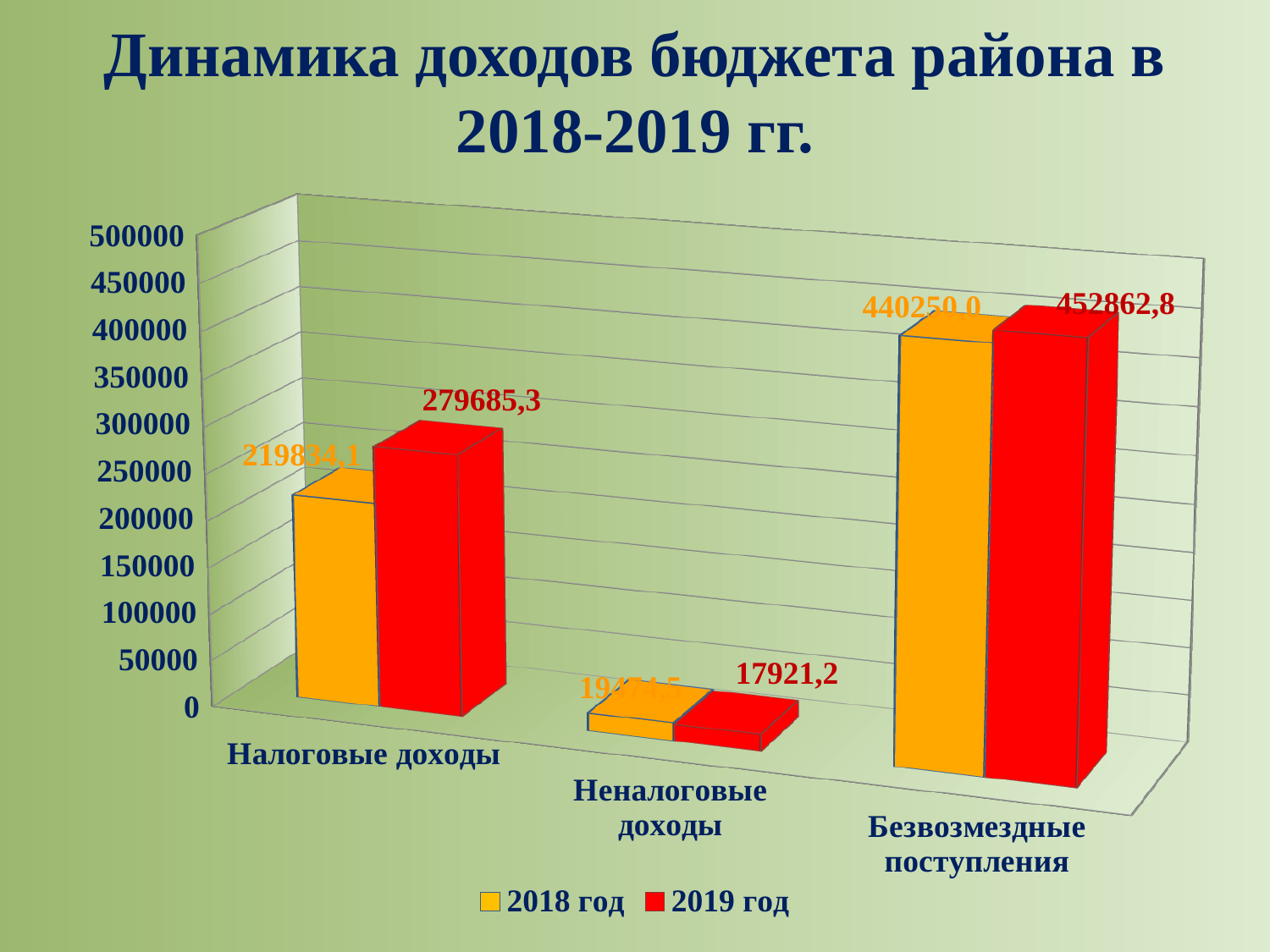
Which category has the highest value for 2019 год? Безвозмездные поступления How many categories are shown on the x axis? 3 What is the value for Безвозмездные поступления in 2019 год? 452862,8 Which category has the lowest value for 2019 год? Неналоговые доходы What is the difference between the 2019 год and 2018 год values for Налоговые доходы? 59851,2 Is the value for Неналоговые доходы in 2019 год greater or less than 50000? less What is the value for Налоговые доходы in 2018 год? 219834,1 What kind of chart is shown on the slide? bar chart How many series does the legend list? 2 What is the value for Налоговые доходы in 2019 год? 279685,3 For Безвозмездные поступления, which year has the larger value, 2018 год or 2019 год? 2019 год What is the value for Неналоговые доходы in 2019 год? 17921,2